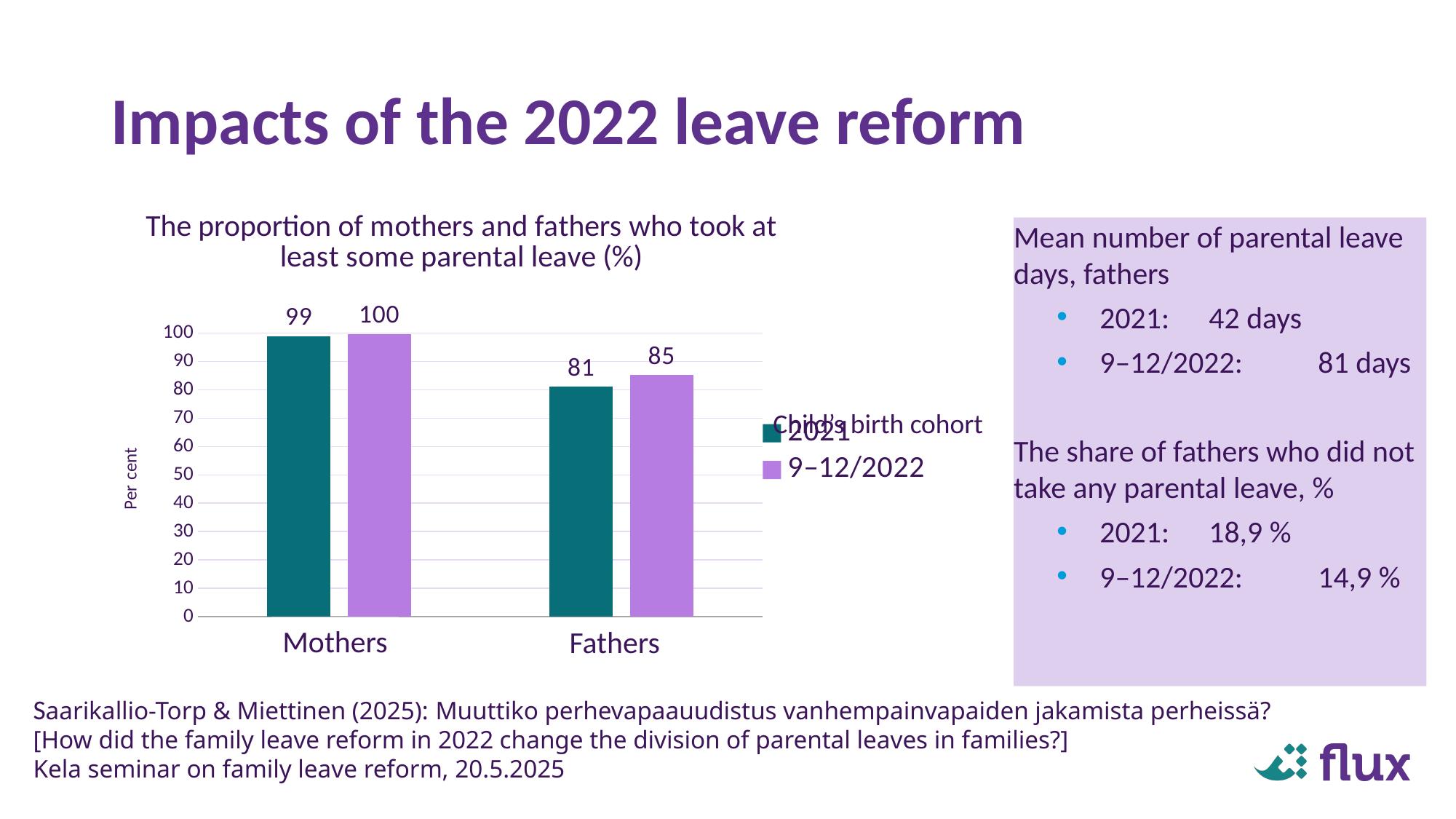
Which category has the highest value in the 9–12/2022 series? Mothers Which is larger for Fathers: the 2021 value or the 9–12/2022 value? 9–12/2022 What is the difference between the 9–12/2022 and 2021 values for Fathers? 4 How many series does the legend list? 2 How many categories are shown on the x axis? 2 What is the value for Fathers in the 2021 series? 81 What is the value for Mothers in the 2021 series? 99 Which category has the lowest value in the 2021 series? Fathers What is the value for Mothers in the 9–12/2022 series? 100 What kind of chart is shown on the slide? Bar chart What is the value for Fathers in the 9–12/2022 series? 85 What is the label of the y axis? Per cent